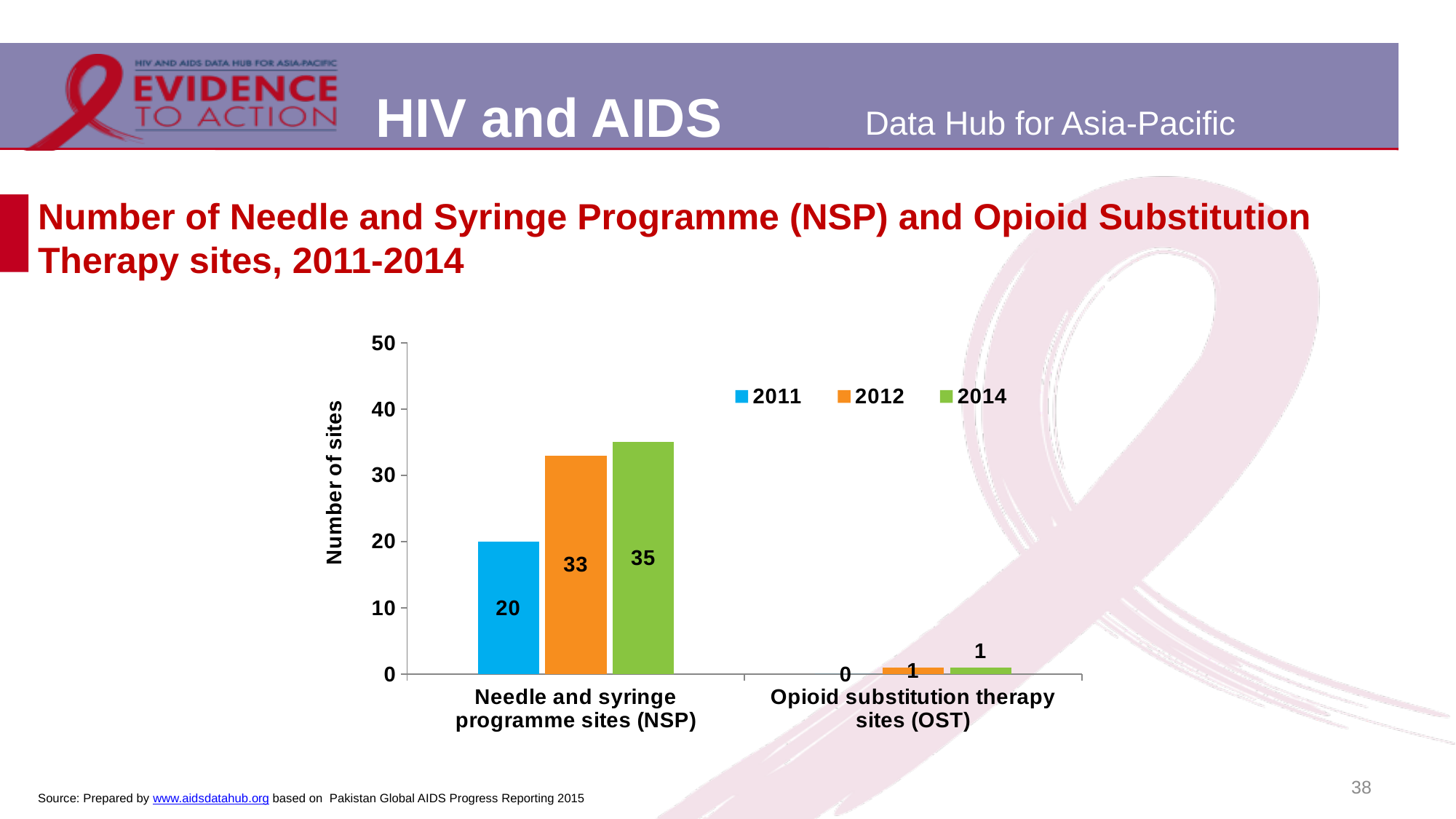
How many series does the legend list? 3 Which year has the highest number of Needle and syringe programme sites (NSP)? 2014 Do the number of NSP sites rise or fall from 2011 to 2014? Rise What is the difference between the number of NSP sites in 2012 and in 2011? 13 What is the number of Opioid substitution therapy sites (OST) in 2011? 0 What is the number of Needle and syringe programme sites (NSP) in 2014? 35 Which year has the lowest number of Needle and syringe programme sites (NSP)? 2011 Is the number of NSP sites in 2012 greater or less than 30? greater Which is larger: the number of NSP sites in 2014 or the number of OST sites in 2014? NSP sites in 2014 What kind of chart is shown on the slide? Bar chart What is the number of Opioid substitution therapy sites (OST) in 2012? 1 What is the number of Needle and syringe programme sites (NSP) in 2011? 20